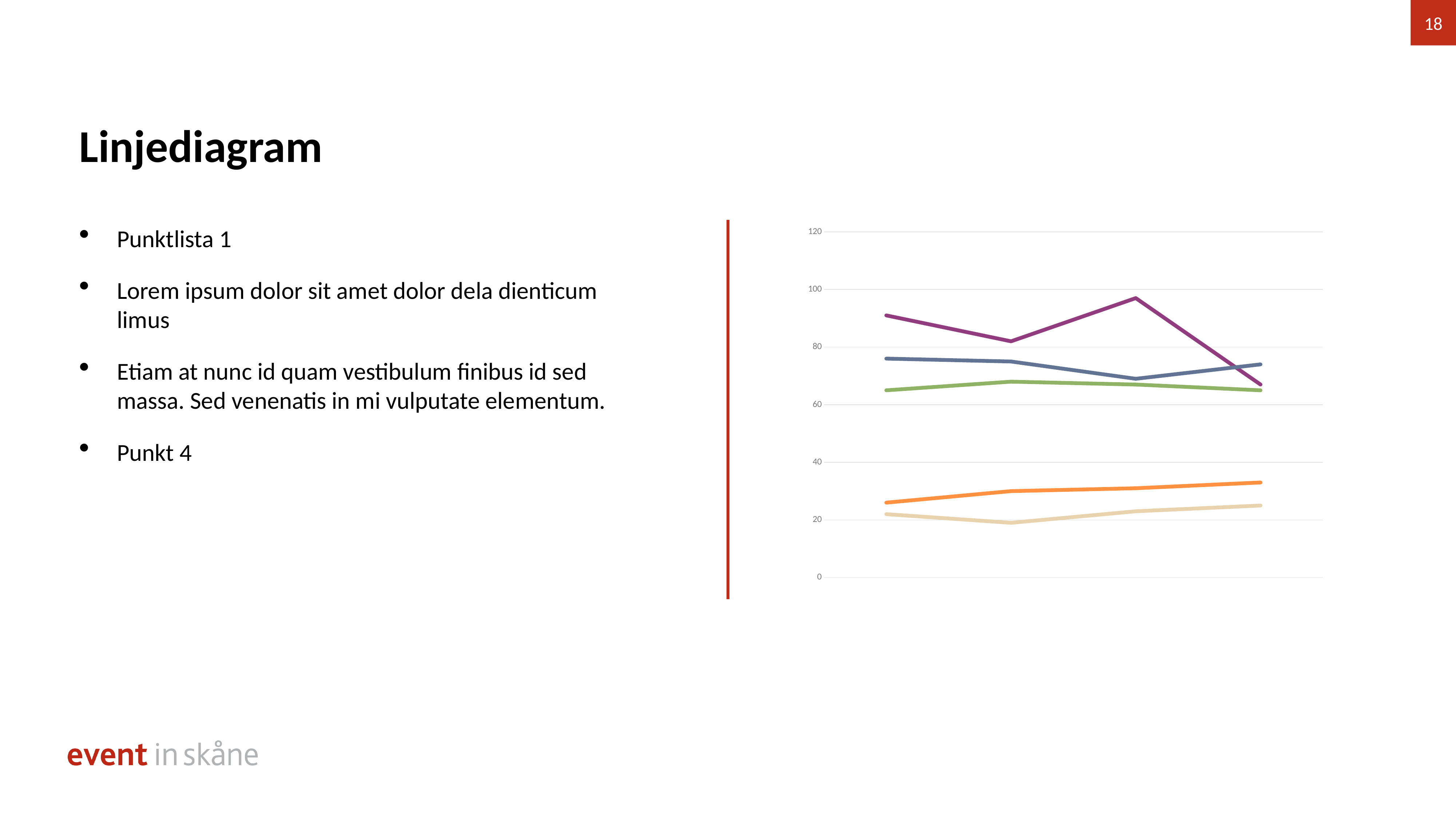
Which line has the lowest value at the second point? beige line How many data points does each line on the chart have? 4 Which line has the highest value at the third point? purple line Is the value of the green line at its last point greater or less than 80? less Is the value of the purple line at its third point greater or less than 80? greater How many lines are plotted on the chart? 5 At the first point, which line has the larger value, the purple line or the green line? purple line What kind of chart is shown on the slide? line chart Is the value of the orange line at its last point greater or less than 40? less What is the highest value shown on the chart's y axis? 120 Does the orange line rise or fall from left to right along the x axis? rises